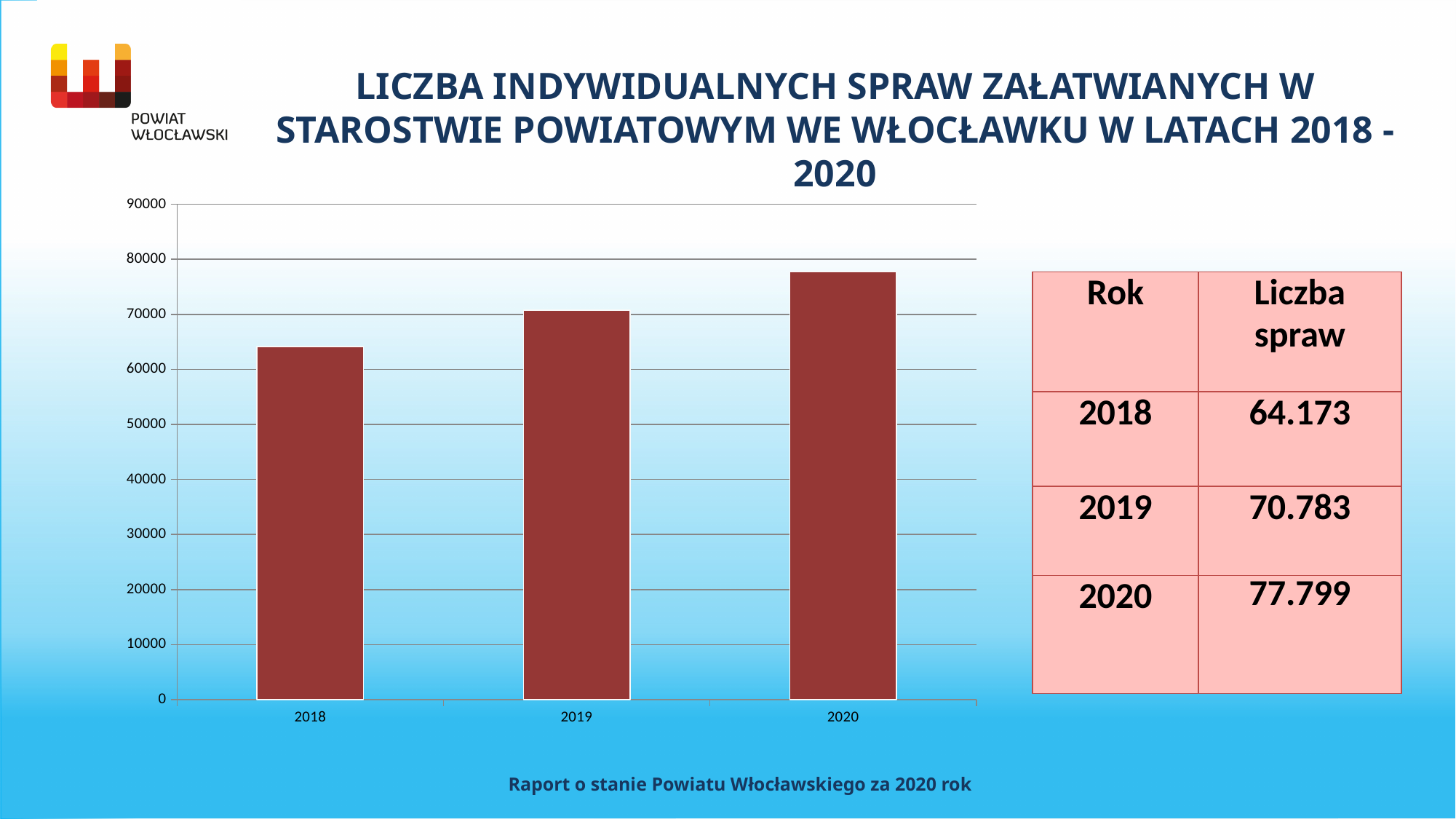
Which year has more cases, 2018 or 2019? 2019 What is the number of cases (liczba spraw) for 2018? 64.173 What is the difference in the number of cases between 2019 and 2018? 6.610 Do the values rise or fall from 2018 to 2020? rise Which year has the highest number of cases? 2020 Is the value for 2020 greater or less than 70000? greater What kind of chart is shown on the slide? bar chart How many years (bars) are plotted in the chart? 3 What is the number of cases (liczba spraw) for 2019? 70.783 What is the number of cases (liczba spraw) for 2020? 77.799 Which year has the lowest number of cases? 2018 What is the difference in the number of cases between 2020 and 2019? 7.016